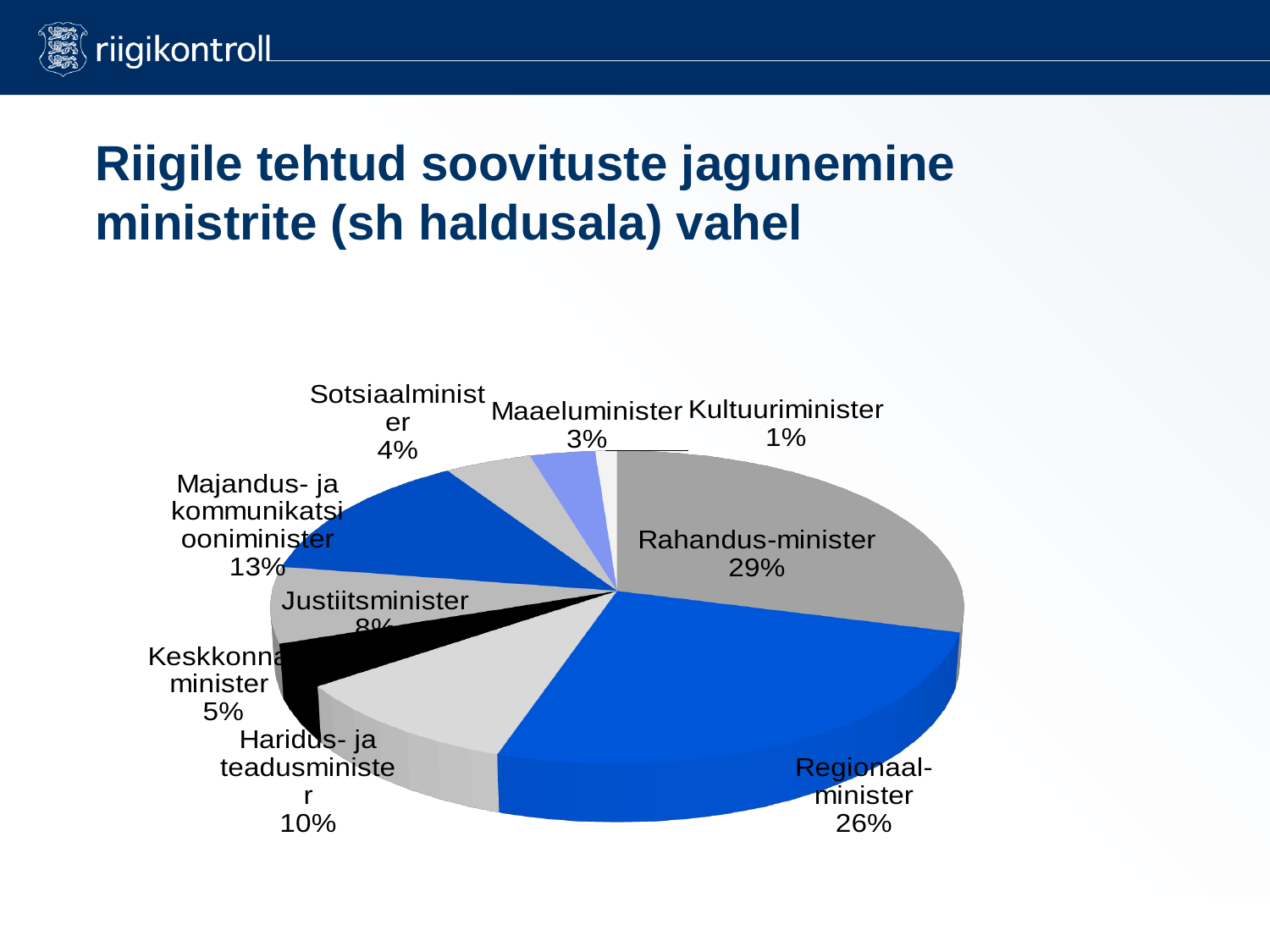
What share of the pie does Regionaal-minister have? 26% What is the value shown for Majandus- ja kommunikatsiooniminister? 13% Which category has the largest share of the pie? Rahandus-minister What share of the pie does Rahandus-minister have? 29% What is the value shown for Keskkonnaminister? 5% Which category has the smallest share of the pie? Kultuuriminister Which is larger, the share for Sotsiaalminister or the share for Maaeluminister? Sotsiaalminister How many slices does the pie chart have? 9 What is the value shown for Haridus- ja teadusminister? 10% What is the difference between the shares of Rahandus-minister and Regionaal-minister? 3% What is the value shown for Kultuuriminister? 1% What kind of chart is shown on the slide? pie chart